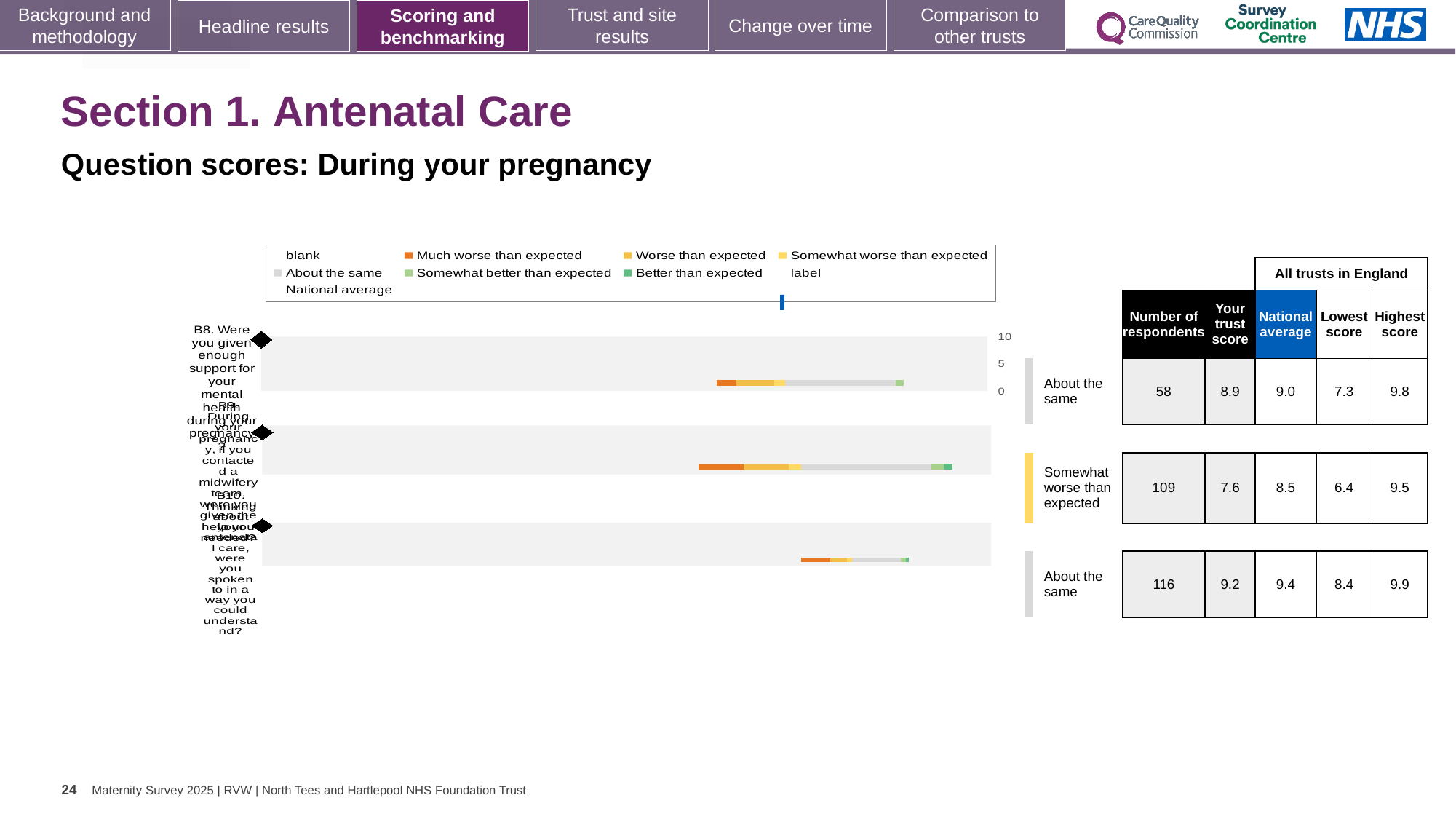
In the table beside the chart, what is the number of respondents for the first row (About the same)? 58 What kind of chart is shown on the slide? bar chart In the table beside the chart, what is the trust score for the row labelled "Somewhat worse than expected"? 7.6 In the table beside the chart, which row has the highest number of respondents? the third row (About the same, 116) In the table beside the chart, is the trust score for the "Somewhat worse than expected" row larger or smaller than its national average? smaller In the table beside the chart, what is the difference between the highest score and the lowest score for the "Somewhat worse than expected" row? 3.1 In the table beside the chart, what is the national average for the third row (About the same, 116 respondents)? 9.4 How many bars are plotted in the chart? 3 What colour does the legend use for "Much worse than expected"? orange What colour does the legend use for "About the same"? grey